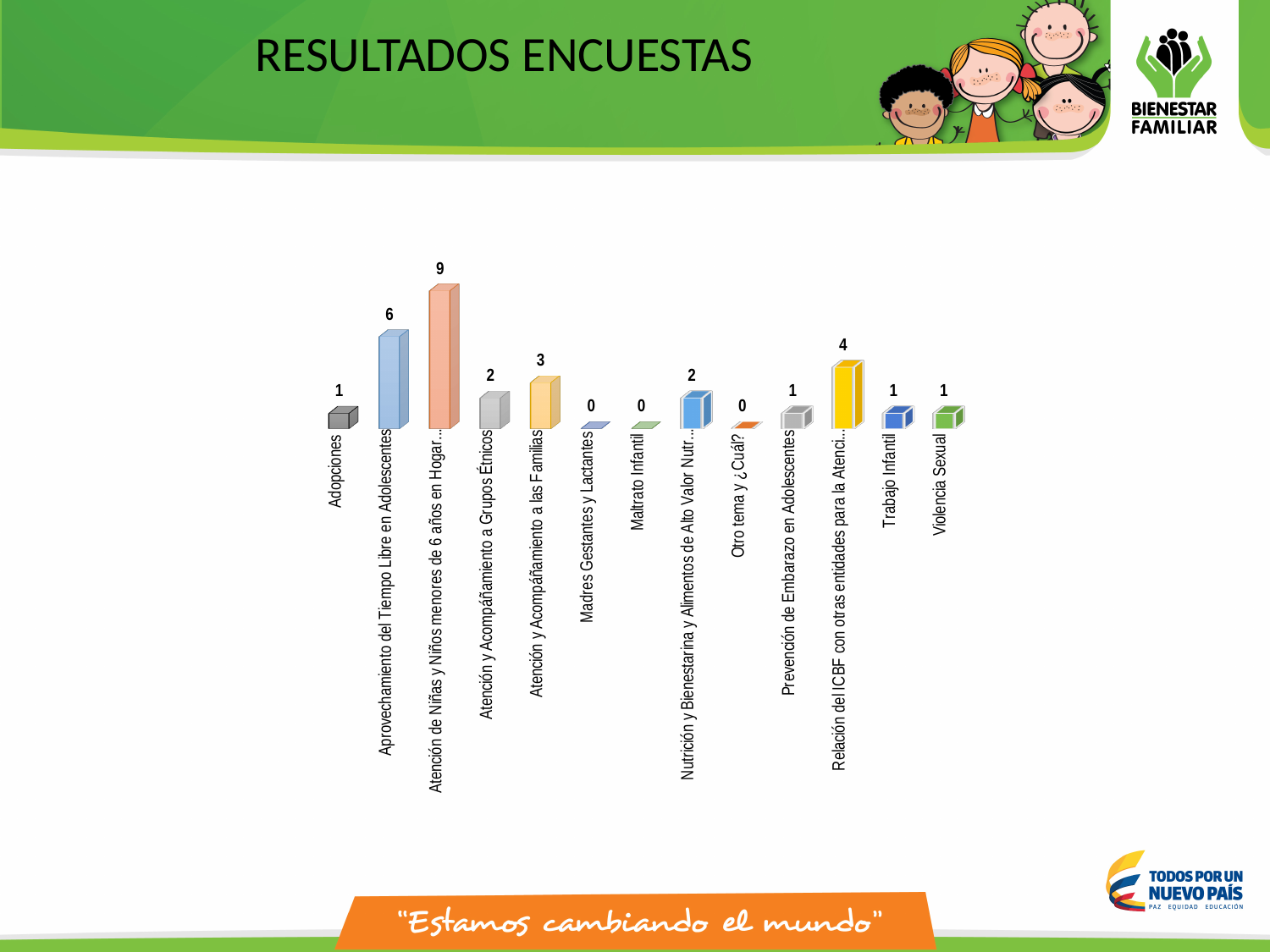
What is the value for Maltrato Infantil? 0 What is the value for Adopciones? 1 What kind of chart is shown on the slide? Bar chart What is the value for Relación del ICBF con otras entidades para la Atenci...? 4 Which is larger, the value for Atención y Acompañamiento a Grupos Étnicos or the value for Atención y Acompañamiento a las Familias? Atención y Acompañamiento a las Familias What is the title of the slide containing the chart? RESULTADOS ENCUESTAS What is the value for Aprovechamiento del Tiempo Libre en Adolescentes? 6 How many categories are plotted in the chart? 13 What is the difference between the values for Atención de Niñas y Niños menores de 6 años en Hogar... and Aprovechamiento del Tiempo Libre en Adolescentes? 3 How many categories have a value of 0? 3 What is the value for Atención y Acompañamiento a las Familias? 3 Which category has the highest value? Atención de Niñas y Niños menores de 6 años en Hogar...